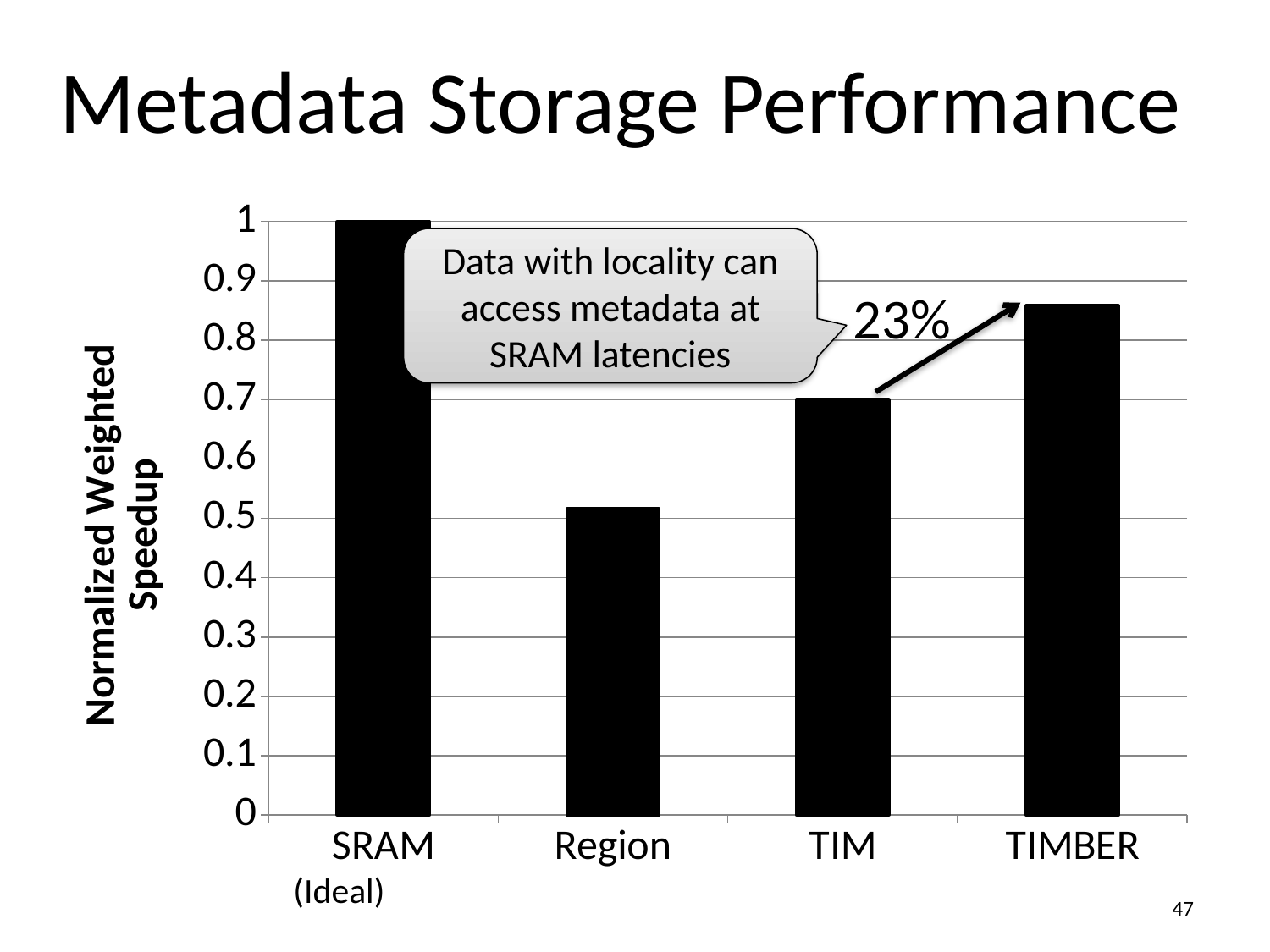
What is the label of the y axis? Normalized Weighted Speedup Is the value for TIMBER greater or less than 0.8? greater What kind of chart is shown on the slide? bar chart Which has a larger normalized weighted speedup, TIM or TIMBER? TIMBER Which category has the lowest normalized weighted speedup? Region What is the normalized weighted speedup for SRAM (Ideal)? 1 What percentage improvement is annotated between TIM and TIMBER? 23% Which has a larger normalized weighted speedup, Region or TIM? TIM Is the value for Region greater or less than 0.6? less Which category has the highest normalized weighted speedup? SRAM (Ideal) Is the value for TIM greater or less than 0.6? greater How many categories are shown on the x axis of the chart? 4